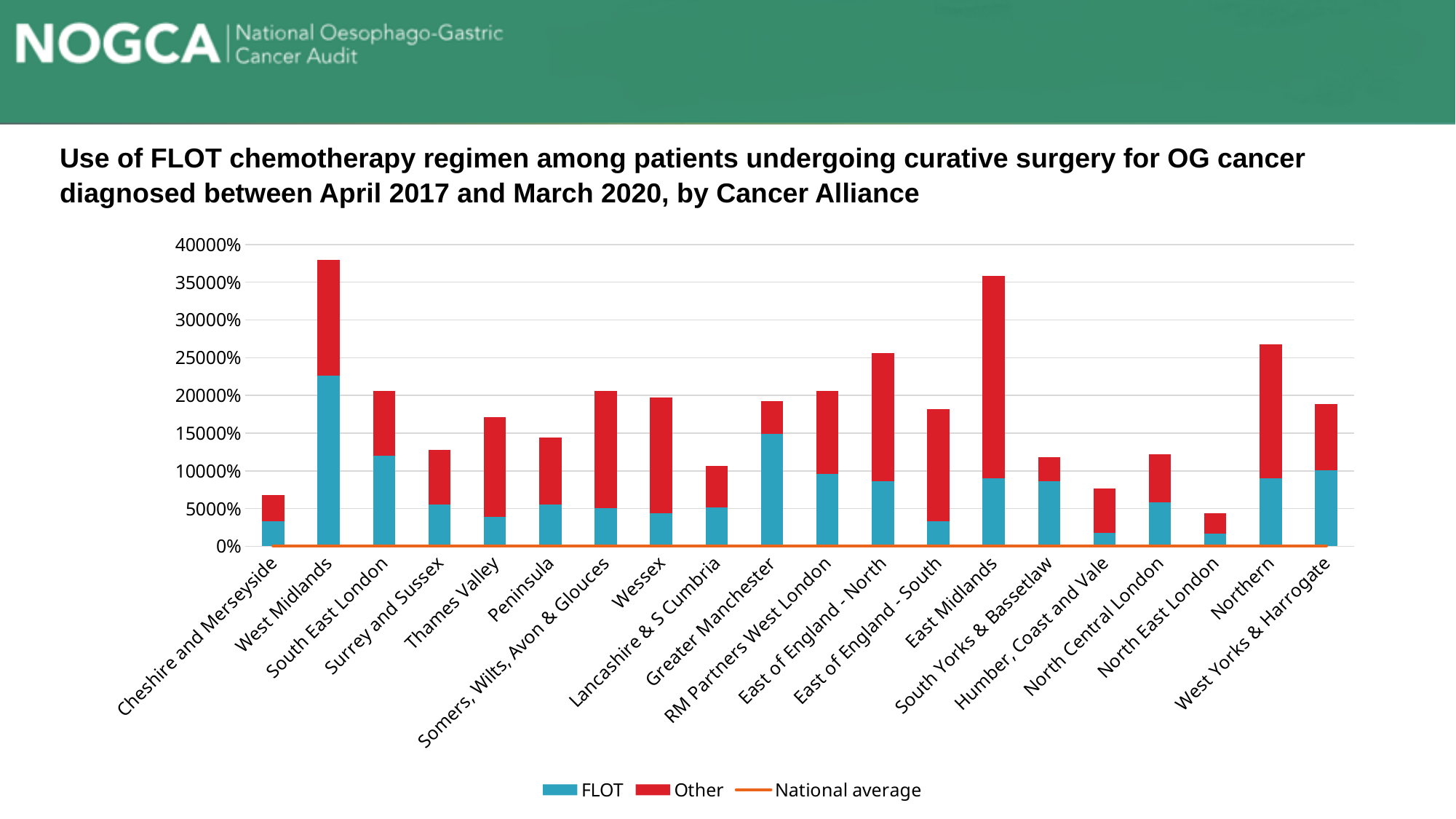
Is the FLOT segment for Greater Manchester greater or less than 10000%? greater Which Cancer Alliance has the shortest stacked bar overall? North East London Is the total bar for Cheshire and Merseyside greater or less than 10000%? less Which Cancer Alliance has the tallest stacked bar overall? West Midlands Which has the larger FLOT segment, Greater Manchester or South East London? Greater Manchester Is the total bar for West Midlands greater or less than 35000%? greater Which Cancer Alliance has the largest FLOT segment? West Midlands How many entries does the legend list? 3 What kind of chart is shown on the slide? Stacked bar chart Which has the taller total bar, Northern or Thames Valley? Northern Which colour represents the FLOT series in the legend? Blue How many Cancer Alliances are shown along the x axis? 20